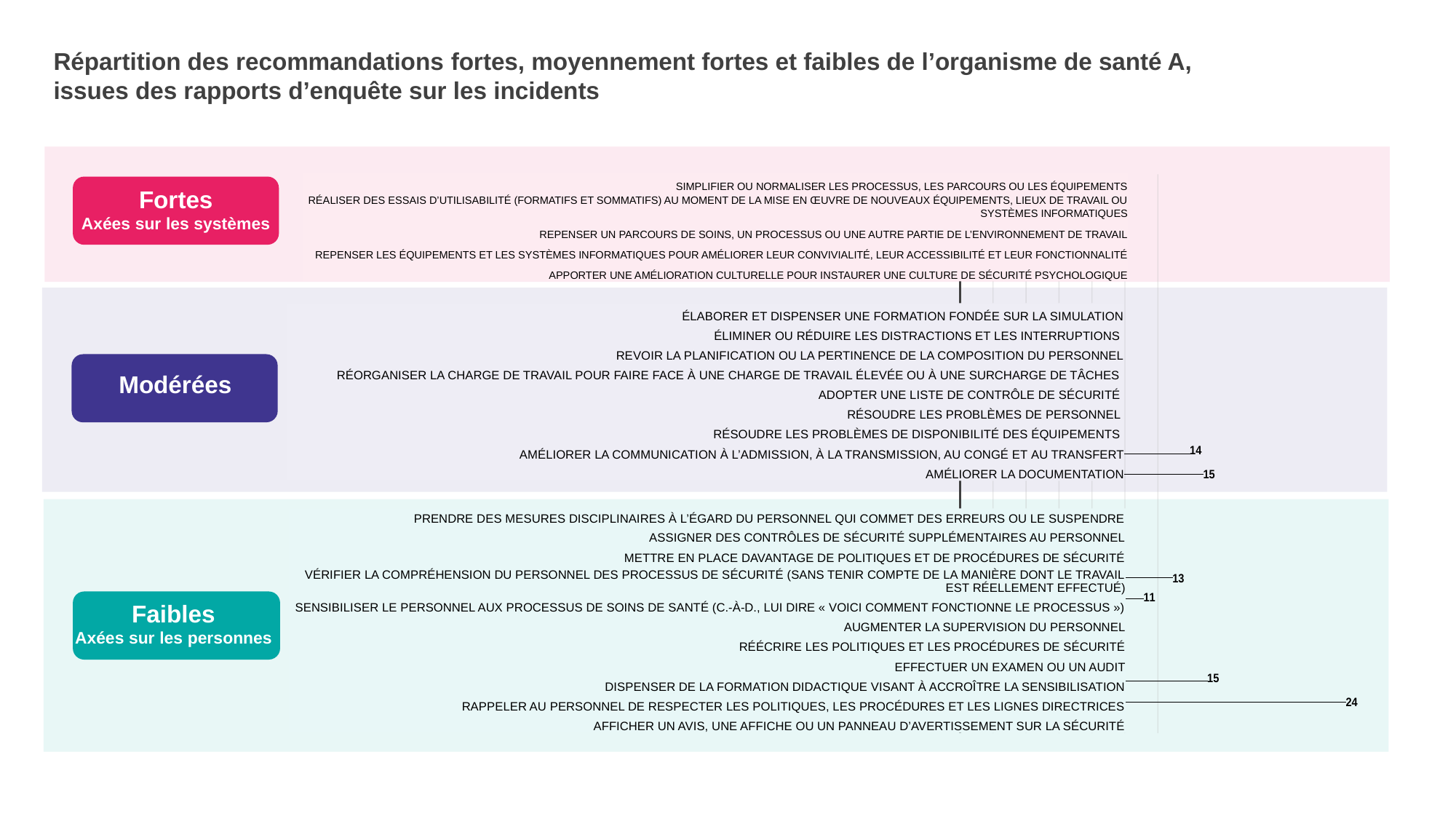
How many recommendations are listed in the Fortes section? 5 What value is shown for « Rappeler au personnel de respecter les politiques, les procédures et les lignes directrices »? 24 What value is shown for « Vérifier la compréhension du personnel des processus de sécurité »? 13 What value is shown for « Sensibiliser le personnel aux processus de soins de santé »? 11 What is the difference between the value for « Rappeler au personnel de respecter les politiques... » and the value for « Dispenser de la formation didactique... »? 9 What value is shown for « Dispenser de la formation didactique visant à accroître la sensibilisation »? 15 How many recommendations are listed in the Faibles section? 11 What kind of chart is shown on the slide? Bar chart What value is shown for « Améliorer la communication à l'admission, à la transmission, au congé et au transfert »? 14 Which recommendation has the highest value on the chart? Rappeler au personnel de respecter les politiques, les procédures et les lignes directrices What value is shown for « Améliorer la documentation » in the Modérées section? 15 Which is larger: the value for « Améliorer la documentation » or the value for « Améliorer la communication à l'admission... »? Améliorer la documentation